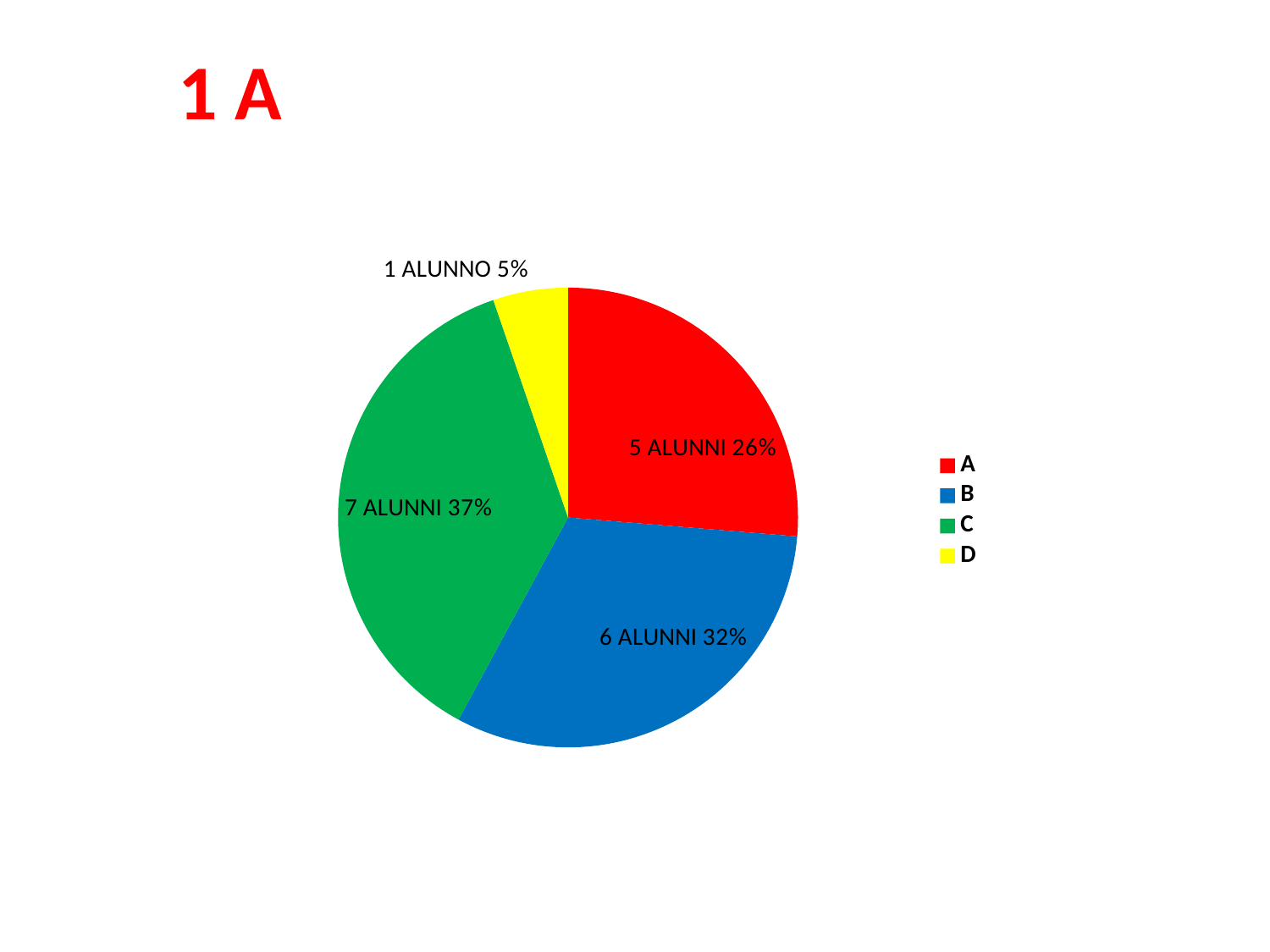
What percentage share does category A have? 26% How many categories does the legend list? 4 What is the total number of students across all four categories? 19 What kind of chart is shown on the slide? pie chart What is the difference in number of students between category C and category A? 2 How many students (alunni) are in category D? 1 What colour is the slice for category D? yellow How many students (alunni) are in category B? 6 What percentage share does category C have? 37% Which category has the smallest slice? D Which is larger, the slice for A or the slice for B? B Which category has the largest slice? C